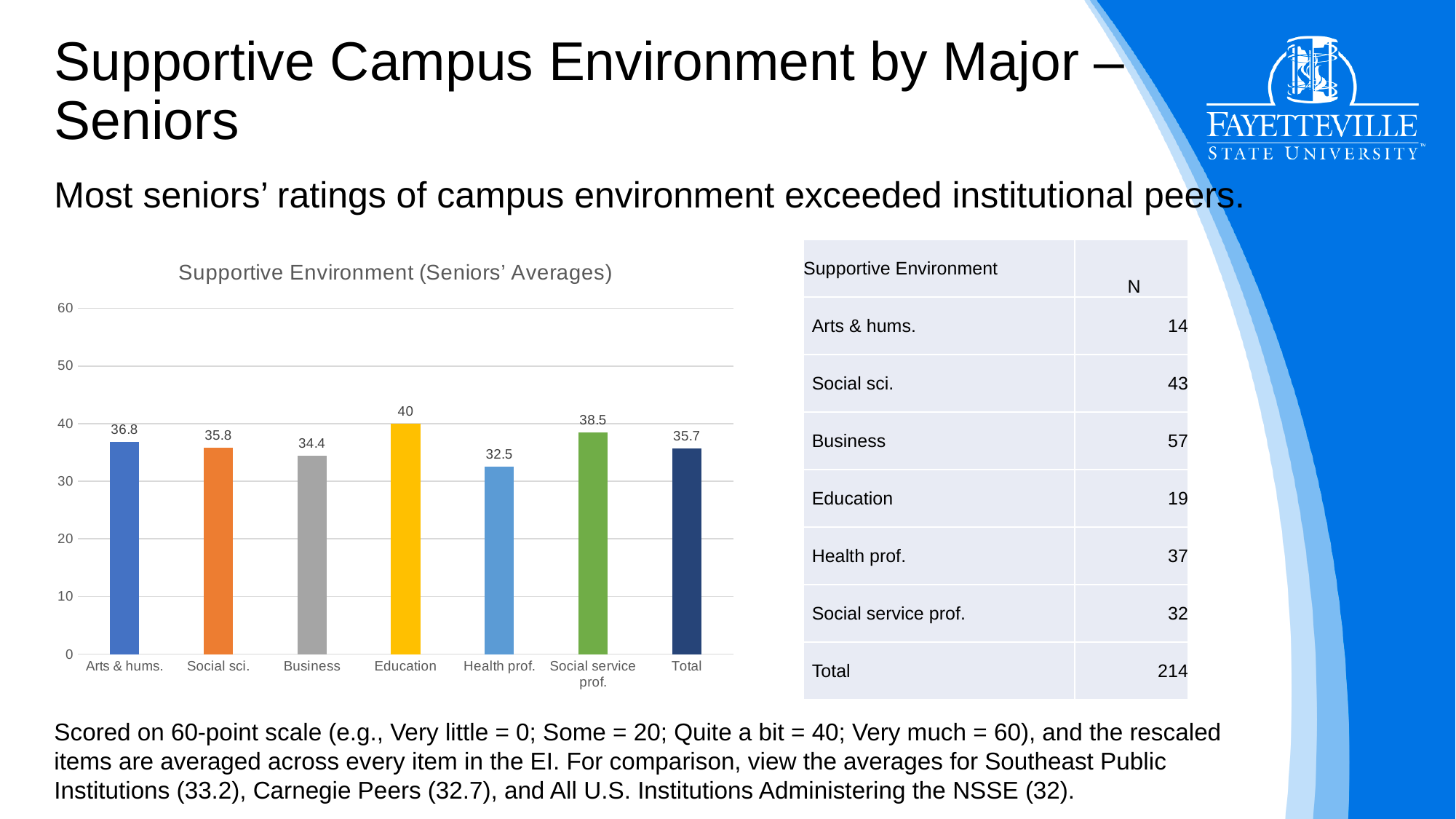
What is the difference between the values for Education and Health prof.? 7.5 How many categories are shown on the x axis of the chart? 7 Which category has the highest value in the chart? Education What is the value for Social service prof. in the chart? 38.5 What is the value for Total in the chart? 35.7 Which category has the lowest value in the chart? Health prof. What is the value for Health prof. in the chart? 32.5 What kind of chart is shown on the slide? Bar chart Which is larger, the value for Social sci. or the value for Business? Social sci. What is the value for Education in the Supportive Environment (Seniors' Averages) chart? 40 What is the title of the chart? Supportive Environment (Seniors' Averages) What is the difference between the values for Arts & hums. and Business? 2.4